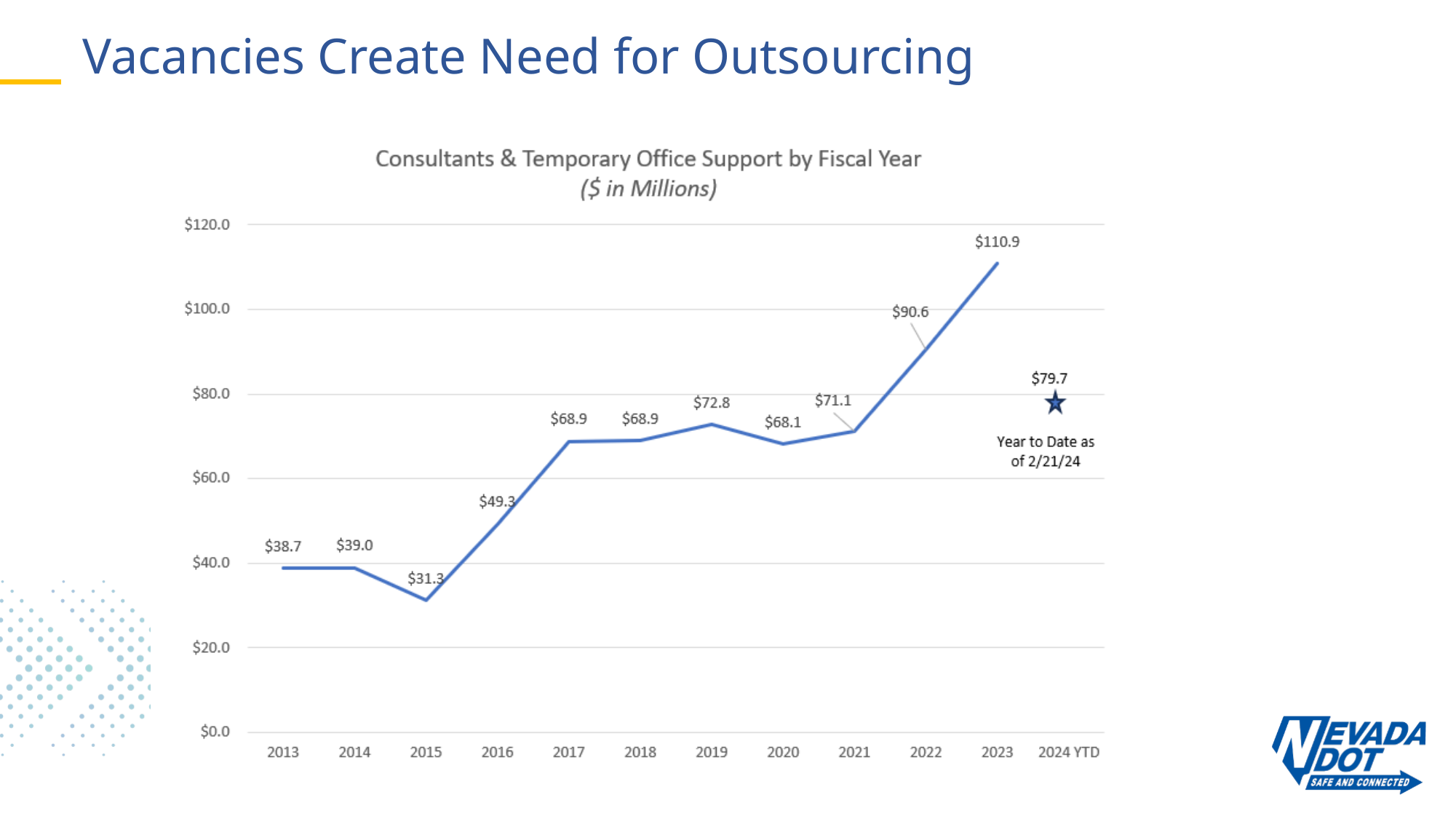
Is the value for 2022 greater or less than $80.0? greater Do the values rise or fall from 2021 to 2023? rise What is the value for 2015? $31.3 How many fiscal year categories are shown on the x axis? 12 What is the value for 2023? $110.9 What is the title of the chart? Consultants & Temporary Office Support by Fiscal Year ($ in Millions) What kind of chart is this? line chart Which fiscal year has the highest value? 2023 What is the value shown for 2024 YTD? $79.7 Which fiscal year has the lowest value? 2015 What is the difference between the 2023 value and the 2022 value? $20.3 Which is larger, the value for 2019 or the value for 2020? 2019